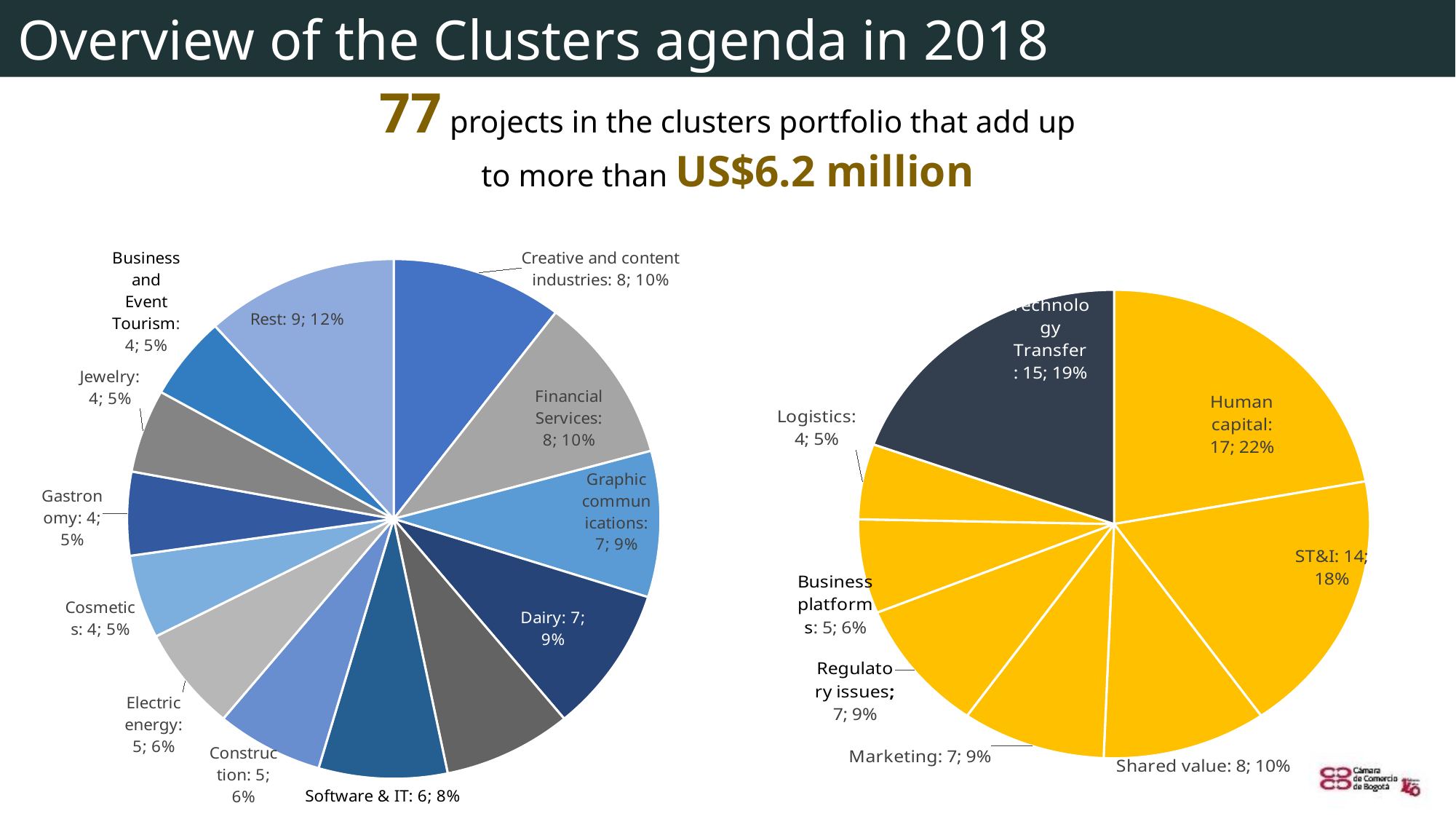
In the right pie chart, which has more projects, Shared value or Marketing? Shared value In the right pie chart, which slice has the largest number of projects? Human capital In the left pie chart, how many slices are there? 13 In the right pie chart, what is the difference in projects between Human capital and ST&I? 3 In the right pie chart, which slice has the smallest number of projects? Logistics In the right pie chart, how many slices are there? 8 In the right pie chart, what share of the pie is Technology Transfer? 19% In the left pie chart, what share of the pie is the Rest slice? 12% In the left pie chart, how many projects does Software & IT have? 6 What kind of charts are shown on the slide? Pie charts In the left pie chart, which slice has the largest number of projects? Rest In the left pie chart, how many projects does the Financial Services slice represent? 8